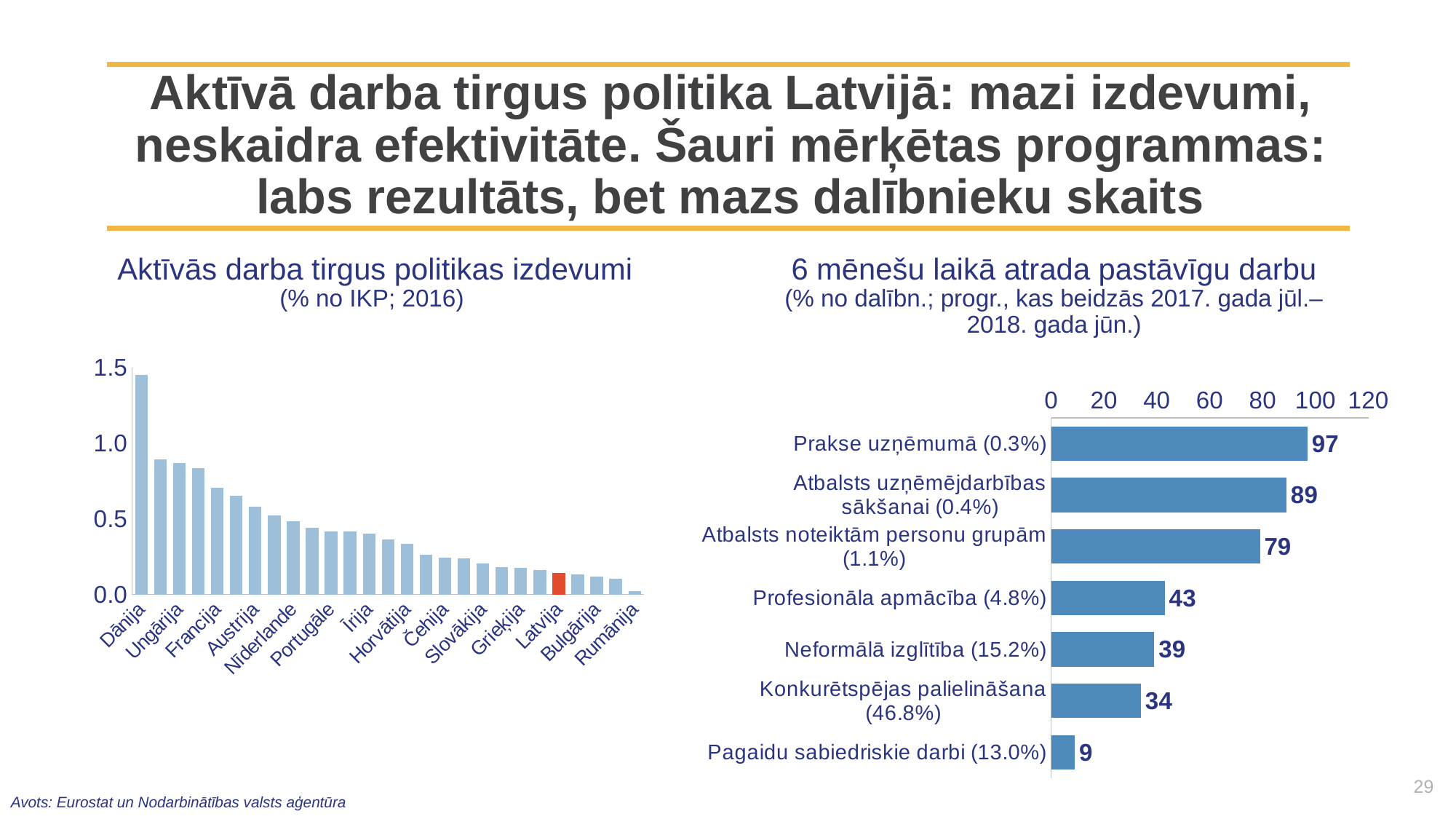
In the chart titled "6 mēnešu laikā atrada pastāvīgu darbu", what is the value for Neformālā izglītība (15.2%)? 39 In the chart titled "Aktīvās darba tirgus politikas izdevumi", which country's bar is highlighted in red? Latvija In the chart titled "6 mēnešu laikā atrada pastāvīgu darbu", which category has the highest value? Prakse uzņēmumā (0.3%) In the chart titled "6 mēnešu laikā atrada pastāvīgu darbu", which is larger: the value for Konkurētspējas palielināšana (46.8%) or the value for Atbalsts noteiktām personu grupām (1.1%)? Atbalsts noteiktām personu grupām (1.1%) What kind of chart is the chart titled "6 mēnešu laikā atrada pastāvīgu darbu"? bar chart In the chart titled "6 mēnešu laikā atrada pastāvīgu darbu", which category has the lowest value? Pagaidu sabiedriskie darbi (13.0%) In the chart titled "Aktīvās darba tirgus politikas izdevumi", do the values rise or fall from left to right along the x axis? fall In the chart titled "Aktīvās darba tirgus politikas izdevumi", is the value for Dānija greater or less than 1.0? greater In the chart titled "6 mēnešu laikā atrada pastāvīgu darbu", what is the value for Prakse uzņēmumā (0.3%)? 97 In the chart titled "6 mēnešu laikā atrada pastāvīgu darbu", what is the difference between the values for Atbalsts uzņēmējdarbības sākšanai (0.4%) and Profesionāla apmācība (4.8%)? 46 How many categories are shown in the chart titled "6 mēnešu laikā atrada pastāvīgu darbu"? 7 In the chart titled "Aktīvās darba tirgus politikas izdevumi", is the value for Latvija greater or less than 0.5? less